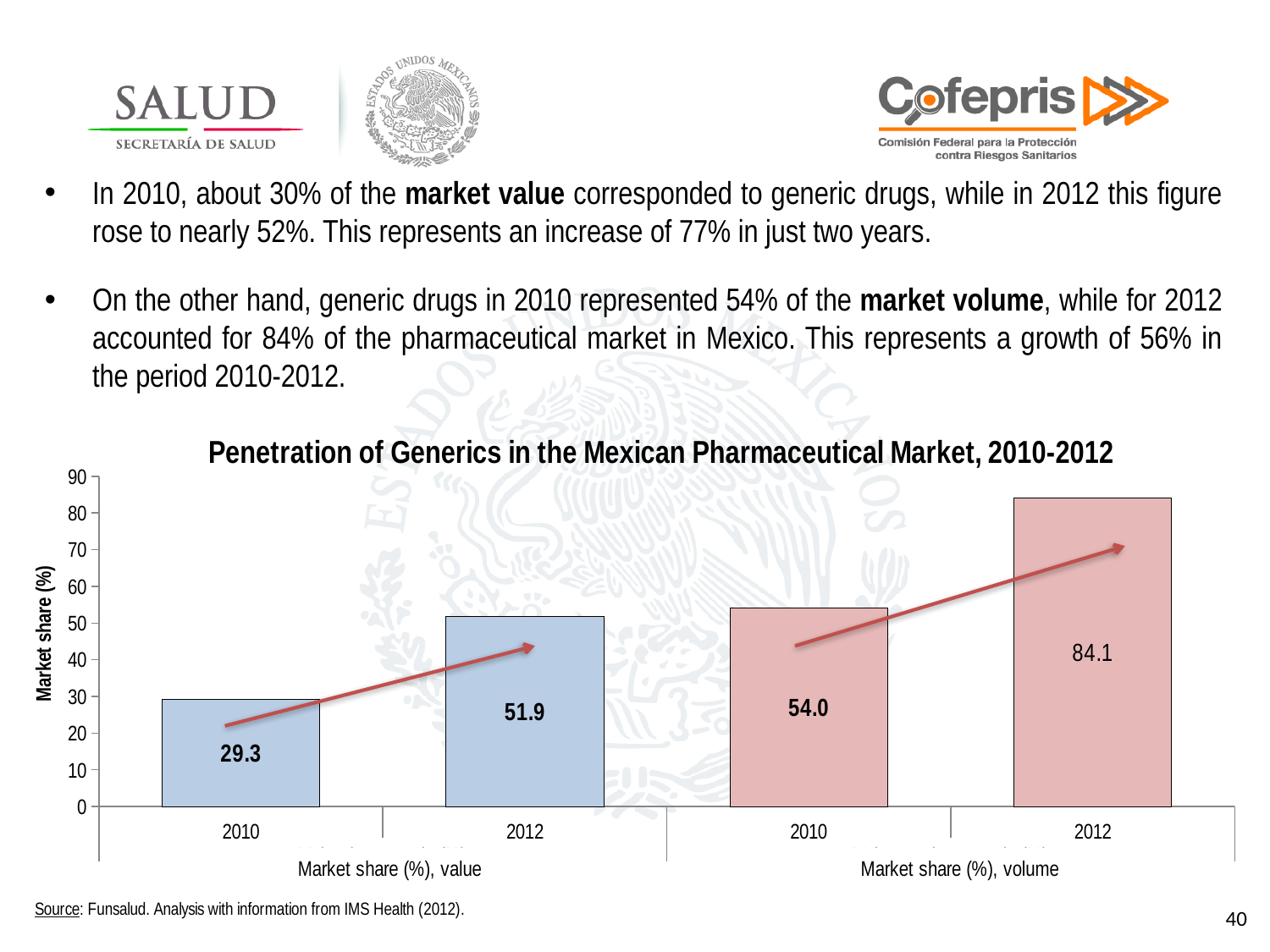
What is the market share (%) by value for generics in 2010? 29.3 What type of chart is shown on the slide? Bar chart What is the market share (%) by value for generics in 2012? 51.9 What is the market share (%) by volume for generics in 2010? 54.0 How many bars are plotted in the chart? 4 What is the title of the chart? Penetration of Generics in the Mexican Pharmaceutical Market, 2010-2012 Which is larger: the 2012 market share by value or the 2010 market share by volume? 2010 market share by volume Which bar shows the highest market share in the chart? 2012, Market share (%), volume Which bar shows the lowest market share in the chart? 2010, Market share (%), value What is the market share (%) by volume for generics in 2012? 84.1 By how much did the market share by value increase from 2010 to 2012? 22.6 By how much did the market share by volume increase from 2010 to 2012? 30.1